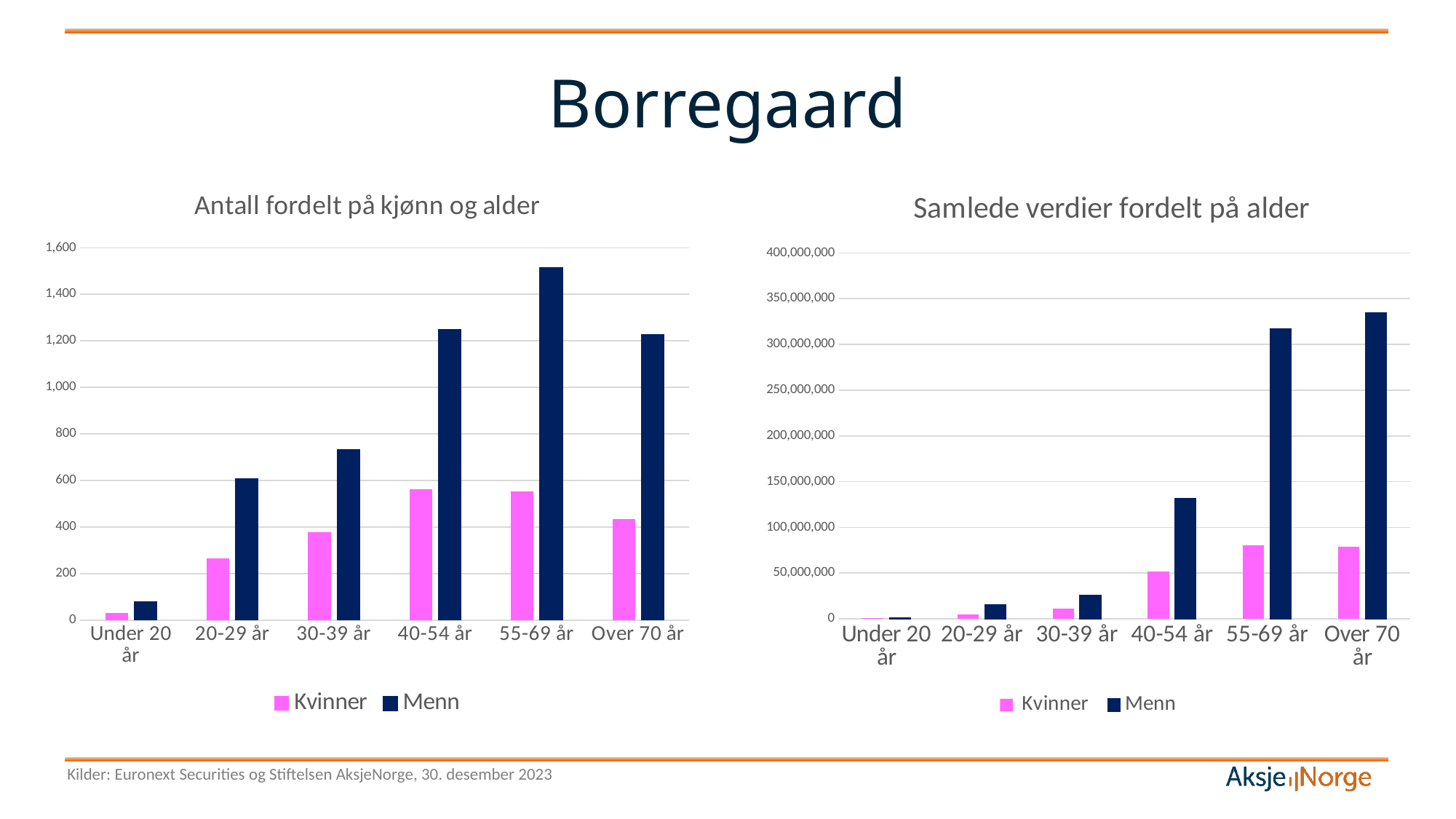
In the left chart "Antall fordelt på kjønn og alder", is the value for Menn in the 40-54 år group greater or less than 1,200? greater In the right chart "Samlede verdier fordelt på alder", is the value for Menn in the 55-69 år group greater or less than 300,000,000? greater In the left chart "Antall fordelt på kjønn og alder", which age group has the lowest value for Kvinner? Under 20 år How many age groups are shown on the x axis of the left chart "Antall fordelt på kjønn og alder"? 6 What are the two legend entries of the left chart "Antall fordelt på kjønn og alder"? Kvinner and Menn In the left chart "Antall fordelt på kjønn og alder", is the value for Kvinner in the 30-39 år group greater or less than 400? less In the left chart "Antall fordelt på kjønn og alder", which is larger for the 20-29 år group, Kvinner or Menn? Menn What kind of chart is the left chart titled "Antall fordelt på kjønn og alder"? bar chart How many series does the legend of the right chart "Samlede verdier fordelt på alder" list? 2 In the left chart "Antall fordelt på kjønn og alder", which age group has the highest value for Menn? 55-69 år In the right chart "Samlede verdier fordelt på alder", which age group has the highest value for Menn? Over 70 år